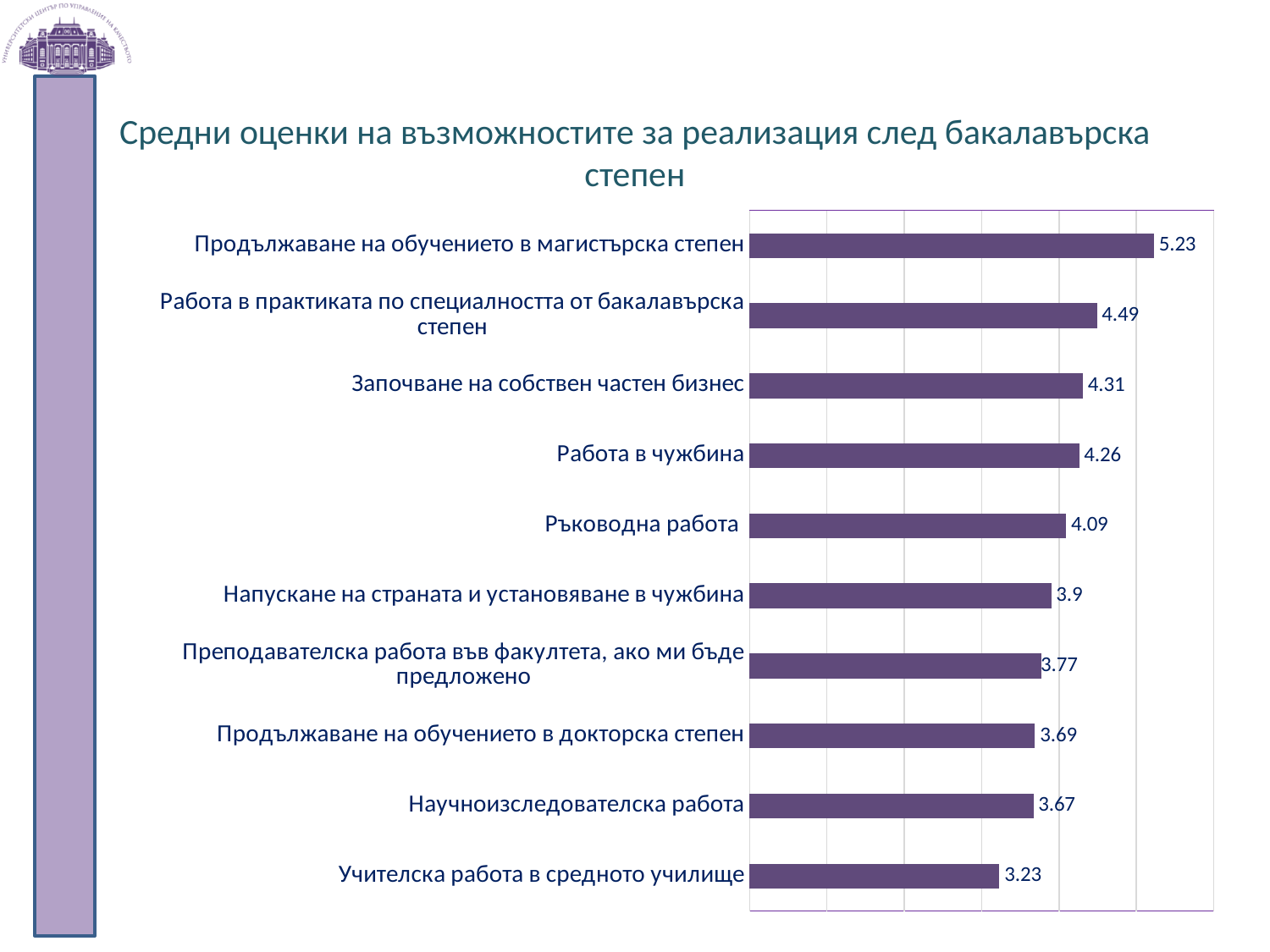
What is the value for "Напускане на страната и установяване в чужбина"? 3.9 What is the title of the chart? Средни оценки на възможностите за реализация след бакалавърска степен What is the value for "Учителска работа в средното училище"? 3.23 What is the value for "Продължаване на обучението в магистърска степен"? 5.23 What is the difference between the values for "Работа в практиката по специалността от бакалавърска степен" and "Започване на собствен частен бизнес"? 0.18 How many categories are shown in the chart? 10 What kind of chart is shown on the slide? Bar chart Which category has the highest value? Продължаване на обучението в магистърска степен What is the difference between the values for "Продължаване на обучението в магистърска степен" and "Учителска работа в средното училище"? 2 Which category has the lowest value? Учителска работа в средното училище What is the value for "Работа в чужбина"? 4.26 Which has a larger value, "Ръководна работа" or "Научноизследователска работа"? Ръководна работа